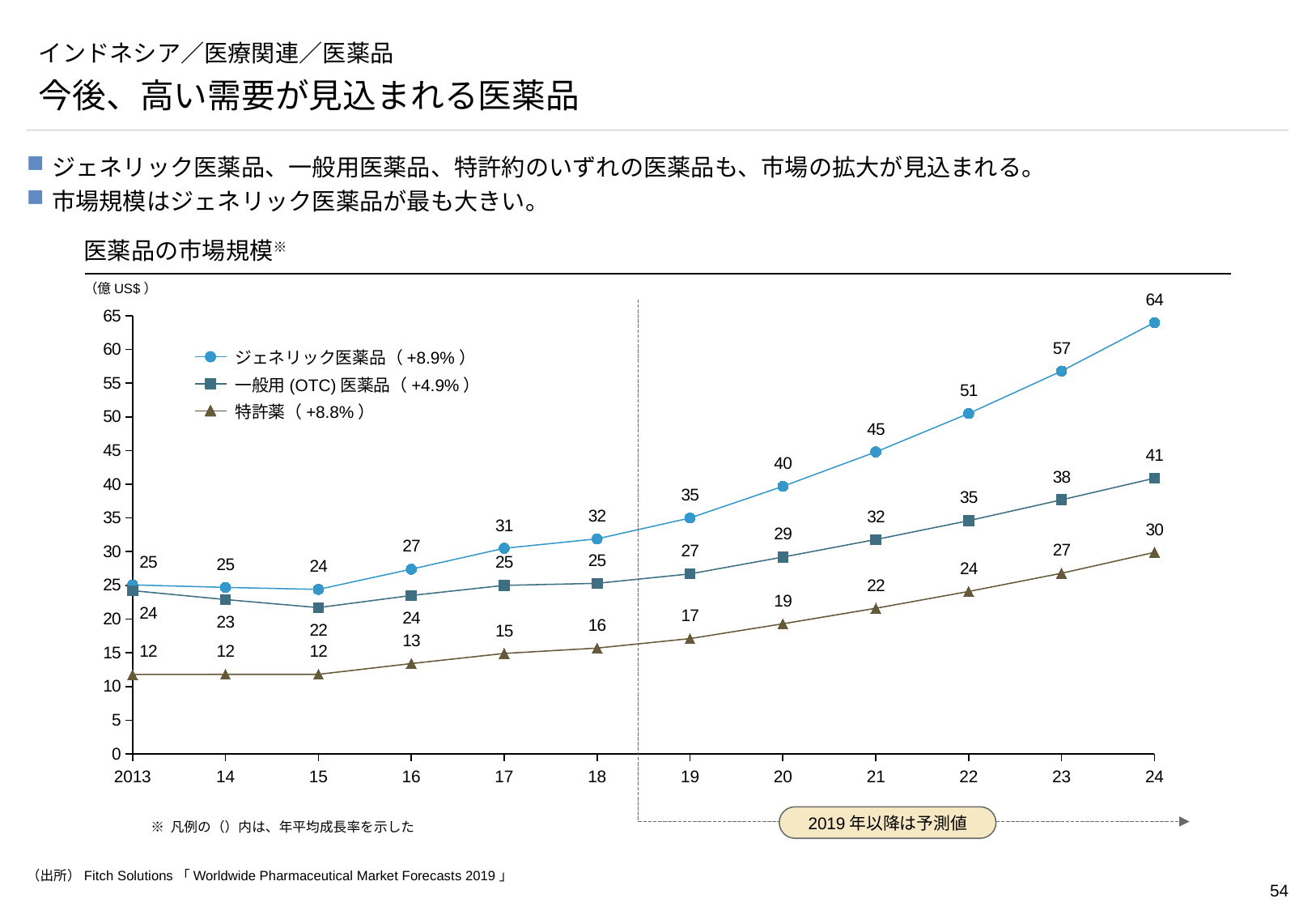
2018年から2024年にかけて特許薬の値は増加していますか、減少していますか？ 増加 2024年のジェネリック医薬品と一般用(OTC)医薬品の差はいくらですか？ 23 一般用(OTC)医薬品の値が最も低いのは何年ですか？ 2015年 2019年の一般用(OTC)医薬品の値はいくらですか？ 27 2020年の一般用(OTC)医薬品と特許薬では、どちらの値が大きいですか？ 一般用(OTC)医薬品 横軸には何年分のデータ点がありますか？ 12 2013年の特許薬の値はいくらですか？ 12 凡例にはいくつの系列がありますか？ 3 2022年のジェネリック医薬品の値は50より大きいですか、小さいですか？ 大きい ジェネリック医薬品の値が最も高いのは何年ですか？ 2024年 2024年のジェネリック医薬品の市場規模はいくらですか？ 64 このグラフの種類は何ですか？ 折れ線グラフ